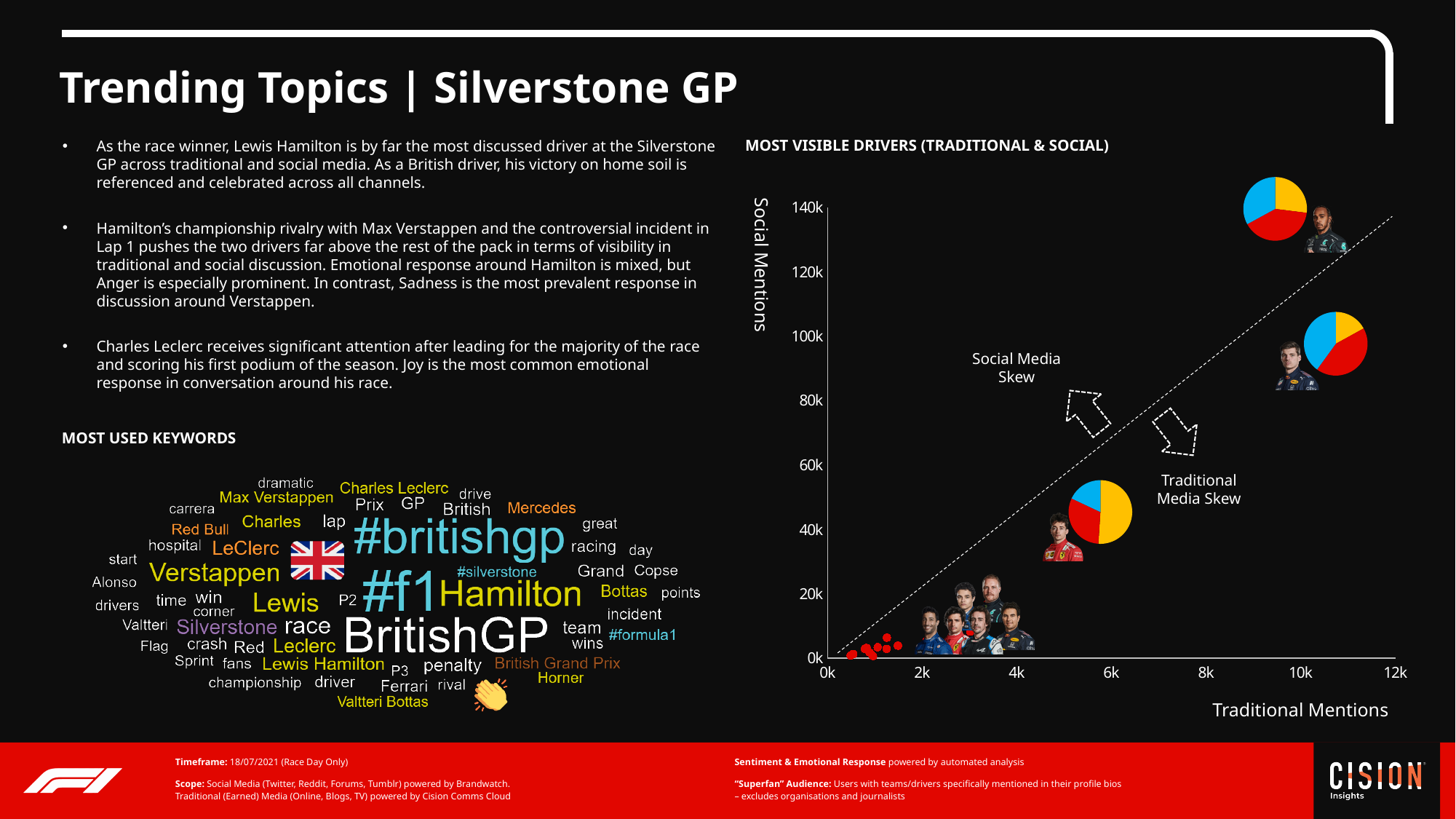
On the 'MOST VISIBLE DRIVERS' chart, what is the highest tick value shown on the vertical axis? 140k On the 'MOST VISIBLE DRIVERS' chart, do social mentions generally rise or fall as traditional mentions increase? rise On the 'MOST VISIBLE DRIVERS' chart, is the traditional mentions value of the third-highest point greater or less than 4k? greater On the 'MOST VISIBLE DRIVERS' chart, what is the label of the horizontal axis? Traditional Mentions What kind of chart is 'MOST VISIBLE DRIVERS (TRADITIONAL & SOCIAL)'? Scatter chart On the 'MOST VISIBLE DRIVERS' chart, is the social mentions value of the highest point greater or less than 120k? greater On the 'MOST VISIBLE DRIVERS' chart, is the traditional mentions value of the highest point greater or less than 8k? greater On the 'MOST VISIBLE DRIVERS' chart, how many points are drawn as pie-chart markers with driver photos? 3 On the 'MOST VISIBLE DRIVERS' chart, what is the label of the vertical axis? Social Mentions